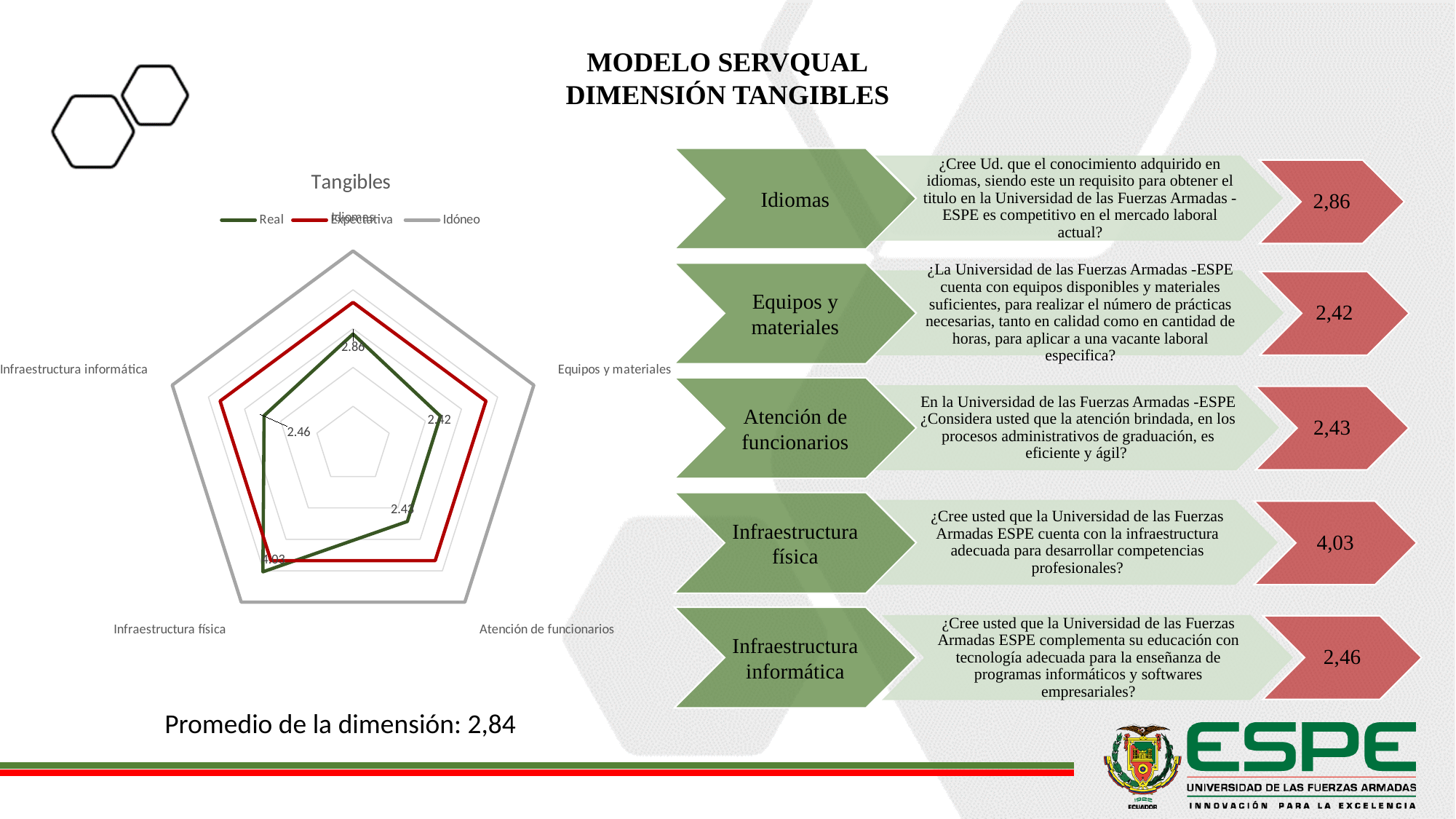
On the "Tangibles" chart, for Infraestructura física, which series has the larger value: Real or Expectativa? Real What colour is the Real series drawn in on the "Tangibles" chart? Green On the "Tangibles" chart, which is larger for the Real series: Idiomas or Infraestructura informática? Idiomas What kind of chart is the "Tangibles" chart? Radar chart What is the Real value for Idiomas on the "Tangibles" chart? 2.86 What is the Real value for Equipos y materiales on the "Tangibles" chart? 2.42 What is the Real value for Infraestructura informática on the "Tangibles" chart? 2.46 On the "Tangibles" chart, for Idiomas, which series has the larger value: Real or Expectativa? Expectativa On the "Tangibles" chart, what is the difference between the Real values for Idiomas and Infraestructura informática? 0.40 How many categories are plotted on the "Tangibles" radar chart? 5 Which category has the highest Real value on the "Tangibles" chart? Infraestructura física How many series does the legend of the "Tangibles" chart list? 3